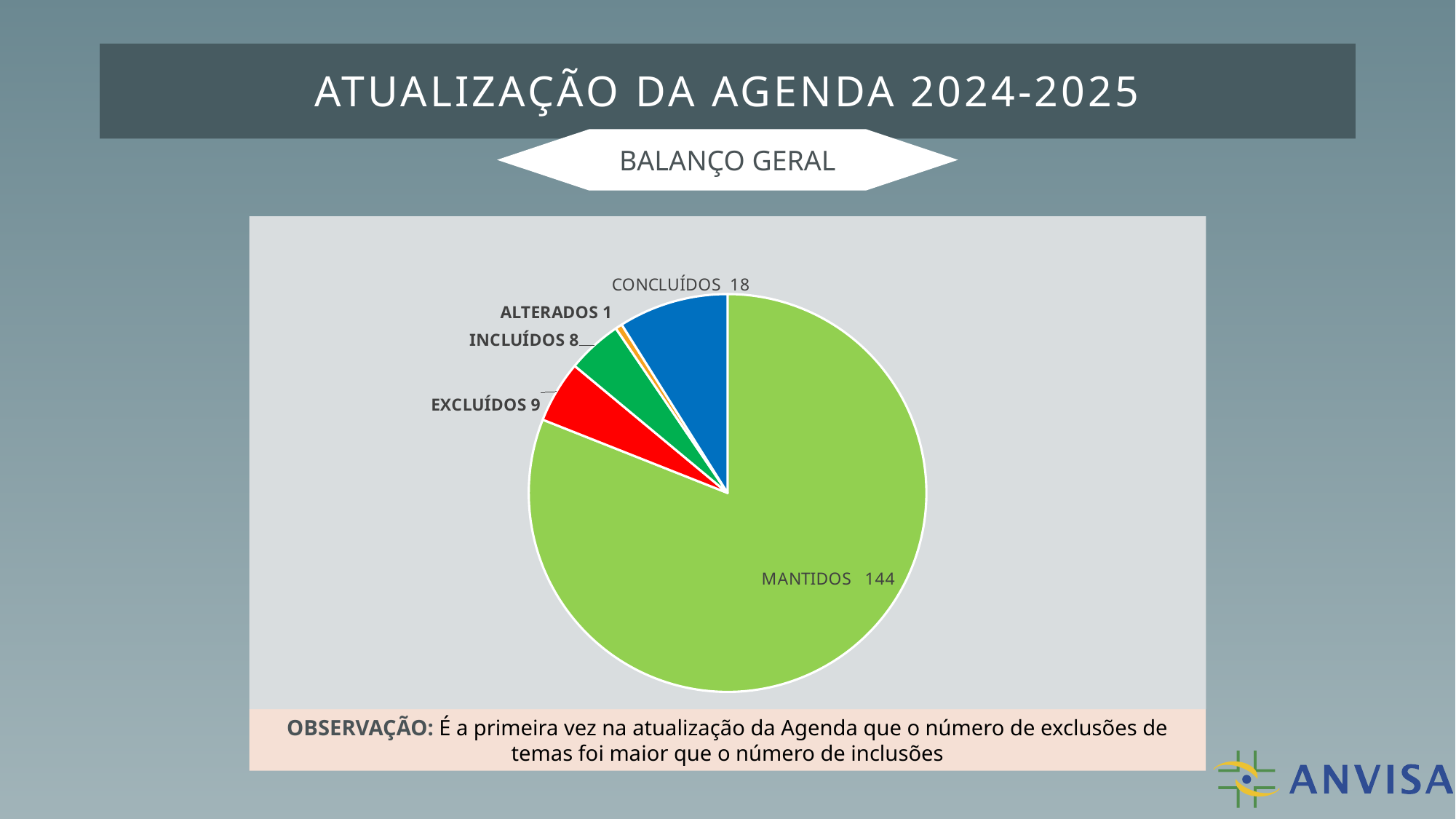
What is the value for CONCLUÍDOS? 18 What is the value for EXCLUÍDOS? 9 What is the value for MANTIDOS? 144 How many slices does the pie chart have? 5 Which category has the smallest slice of the pie? ALTERADOS What is the value for INCLUÍDOS? 8 What type of chart is shown on the slide? pie chart What is the difference between the values for MANTIDOS and CONCLUÍDOS? 126 Which is larger, EXCLUÍDOS or INCLUÍDOS? EXCLUÍDOS What is the value for ALTERADOS? 1 Which category has the largest slice of the pie? MANTIDOS